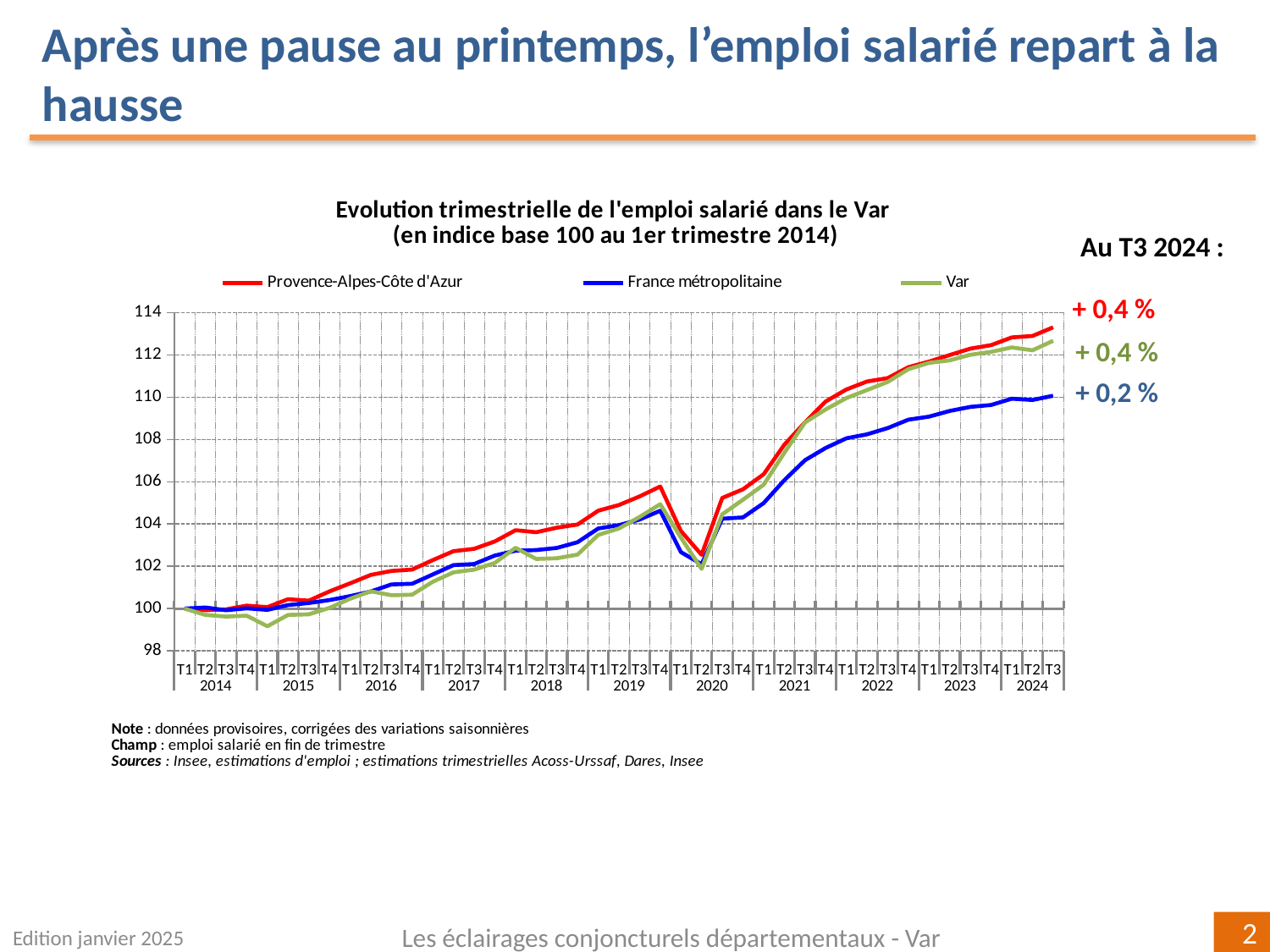
Which series is lowest at T3 2024? France métropolitaine What kind of chart is shown on the slide? line chart What quarterly change is shown for France métropolitaine at T3 2024? + 0,2 % Overall, do the series rise or fall from T1 2014 to T3 2024? rise Is the value for France métropolitaine at T4 2019 greater or less than 104? greater How many years are labelled on the x axis? 11 At T3 2024, which is larger: Provence-Alpes-Côte d'Azur or France métropolitaine? Provence-Alpes-Côte d'Azur How many series does the legend list? 3 Is the value for Provence-Alpes-Côte d'Azur at T3 2024 greater or less than 112? greater Which series is highest at T3 2024? Provence-Alpes-Côte d'Azur What quarterly change is shown for Var at T3 2024? + 0,4 % Is the value for Var at T1 2015 greater or less than 100? less